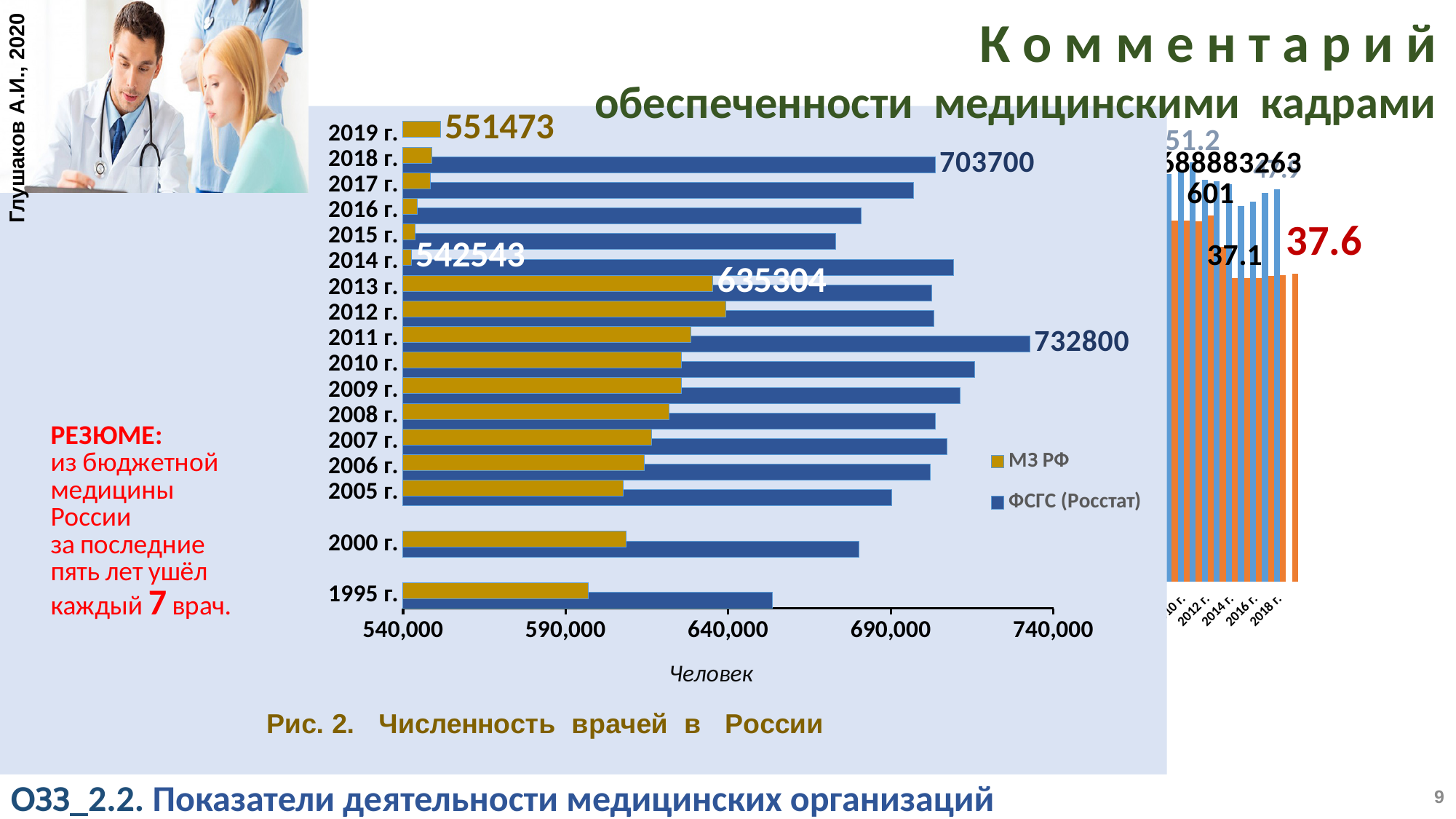
In the chart 'Рис. 2. Численность врачей в России', what is the difference between the МЗ РФ values for 2013 г. and 2019 г.? 83831 In the chart 'Рис. 2. Численность врачей в России', is the ФСГС (Росстат) value for 1995 г. greater or less than 640,000? greater How many series does the legend of the chart 'Рис. 2. Численность врачей в России' list? 2 In the chart 'Рис. 2. Численность врачей в России', which year has the highest ФСГС (Росстат) value? 2011 г. How many years (categories) are shown in the chart 'Рис. 2. Численность врачей в России'? 17 In the chart 'Рис. 2. Численность врачей в России', what is the difference between the ФСГС (Росстат) values for 2011 г. and 2018 г.? 29100 In the chart 'Рис. 2. Численность врачей в России', is the ФСГС (Росстат) value for 2016 г. greater or less than 690,000? less In the chart 'Рис. 2. Численность врачей в России', what is the МЗ РФ value for 2014 г.? 542543 In the chart 'Рис. 2. Численность врачей в России', which year has the lowest ФСГС (Росстат) value? 1995 г. In the chart 'Рис. 2. Численность врачей в России', what is the ФСГС (Росстат) value for 2011 г.? 732800 In the chart 'Рис. 2. Численность врачей в России', what is the ФСГС (Росстат) value for 2018 г.? 703700 In the chart 'Рис. 2. Численность врачей в России', what is the МЗ РФ value for 2019 г.? 551473